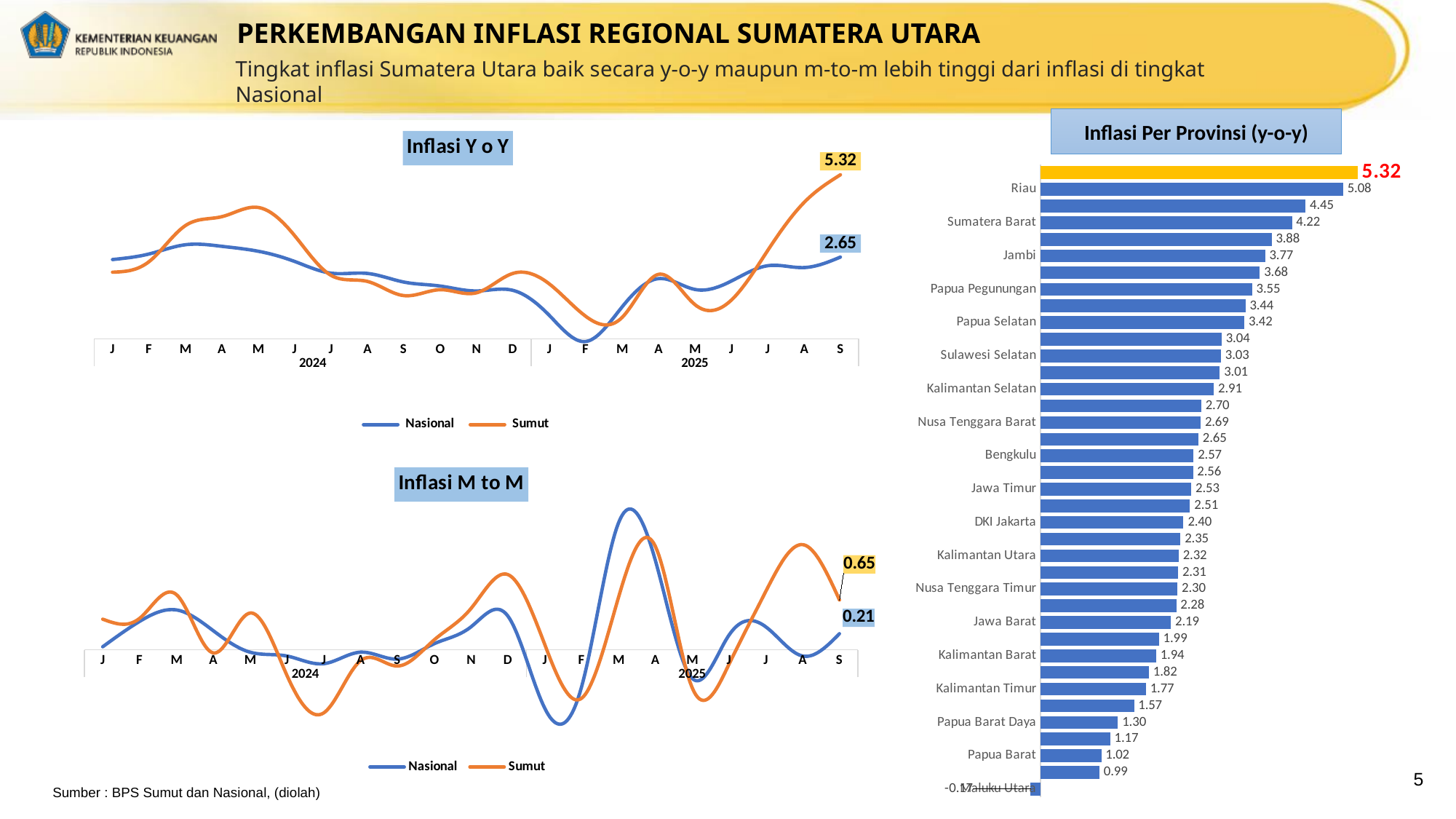
In the Inflasi Per Provinsi (y-o-y) chart, what is the value for Jambi? 3.77 How many series does the legend of the Inflasi Y o Y chart list? 2 In the Inflasi Per Provinsi (y-o-y) chart, what is the value for Riau? 5.08 In the Inflasi Y o Y chart, what is the labelled value for Sumut at the last point (S 2025)? 5.32 In the Inflasi Per Provinsi (y-o-y) chart, what is the difference between the values for Riau and Sumatera Barat? 0.86 In the Inflasi M to M chart, what is the labelled value for Sumut at the last point (S 2025)? 0.65 In the Inflasi Y o Y chart, what is the difference between the final Sumut value and the final Nasional value? 2.67 In the Inflasi Per Provinsi (y-o-y) chart, which province has the lowest value? Maluku Utara In the Inflasi M to M chart, which series has the higher value at the last point, Nasional or Sumut? Sumut What kind of chart is the Inflasi Per Provinsi (y-o-y) chart? bar chart In the Inflasi M to M chart, what is the labelled value for Nasional at the last point (S 2025)? 0.21 In the Inflasi Y o Y chart, what is the labelled value for Nasional at the last point (S 2025)? 2.65